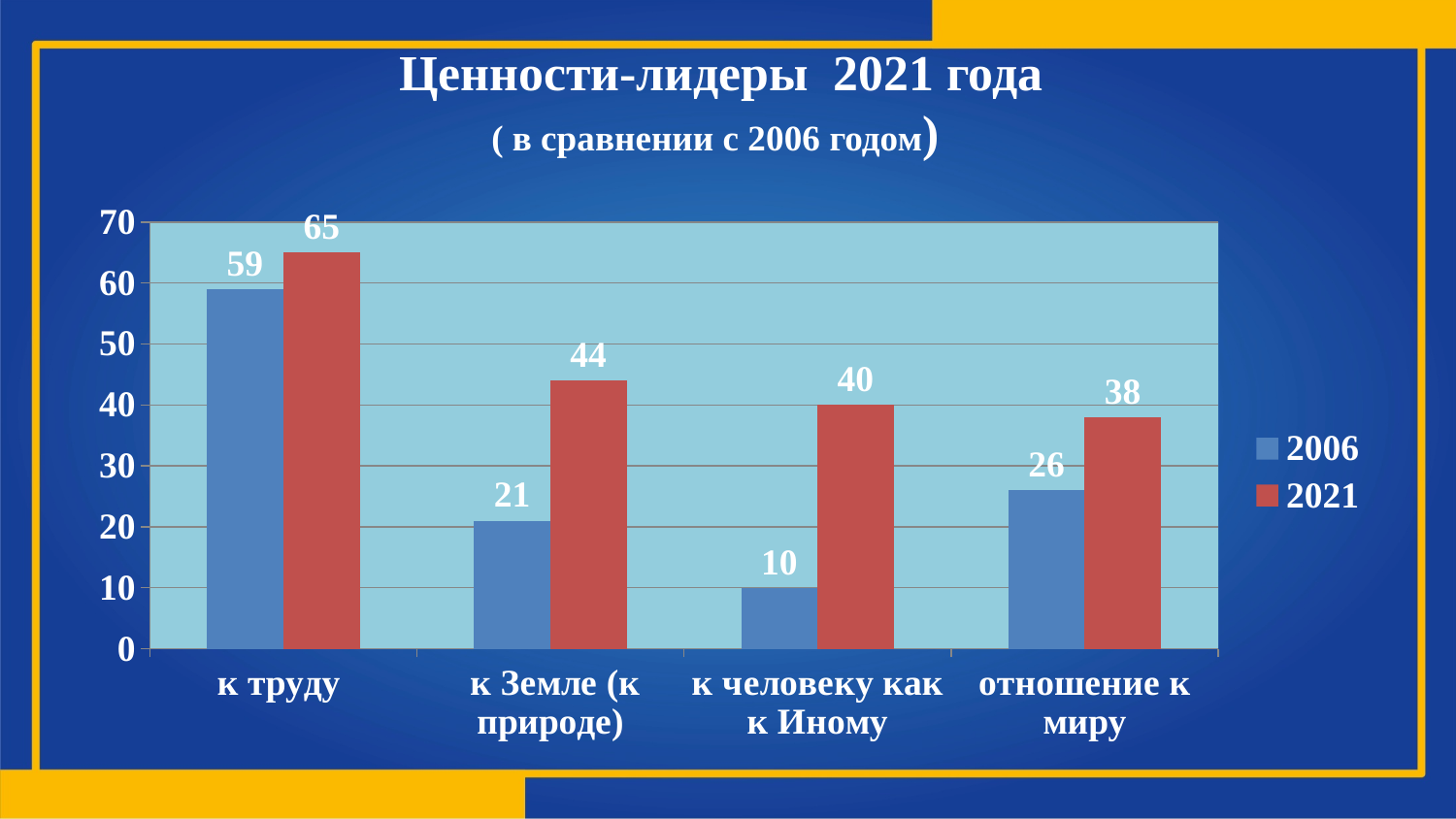
What is the difference between the 2021 and 2006 values for "к человеку как к Иному"? 30 Which category has the lowest 2006 value? к человеку как к Иному What kind of chart is shown on the slide? bar chart How many categories are shown on the x axis? 4 What is the 2006 value for "отношение к миру"? 26 How many series does the legend list? 2 What is the 2021 value for "к Земле (к природе)"? 44 Which category has the highest 2021 value? к труду Which is larger: the 2006 value for "отношение к миру" or the 2006 value for "к Земле (к природе)"? отношение к миру What is the 2006 value for "к человеку как к Иному"? 10 What is the difference between the 2021 and 2006 values for "к труду"? 6 What is the 2021 value for "к труду"? 65